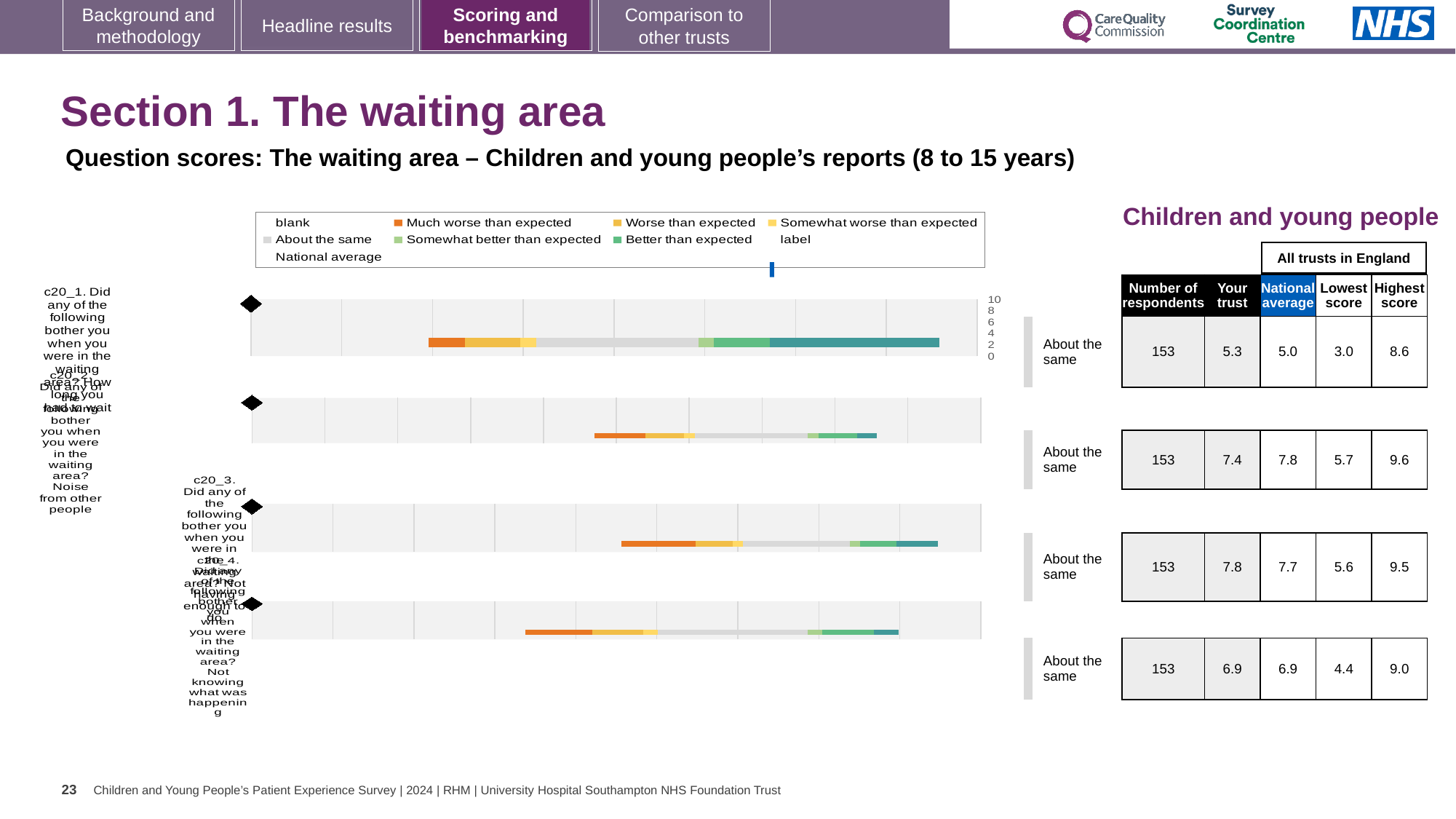
According to the table next to the charts, what is the lowest score for c20_4 (Not knowing what was happening)? 4.4 According to the table next to the charts, what is the highest score for c20_3 (Not having enough to do)? 9.5 In the chart legend, which entry is shown in orange? Much worse than expected For c20_2 (Noise from other people), what is the difference between the national average (7.8) and the 'Your trust' score (7.4)? 0.4 How many entries does the chart legend list? 9 According to the table next to the charts, what is the national average for c20_2 (Noise from other people)? 7.8 Which question has the highest 'Your trust' score in the table next to the charts? c20_3 (Not having enough to do) According to the table next to the charts, what is the 'Your trust' score for c20_1 (How long you had to wait)? 5.3 What is the maximum value shown on the chart's score axis? 10 For c20_2 (Noise from other people), which is larger: the 'Your trust' score or the national average? National average What kind of chart is used to show the question scores on this slide? Bar chart How many separate bar charts (one per question) are shown on the slide? 4